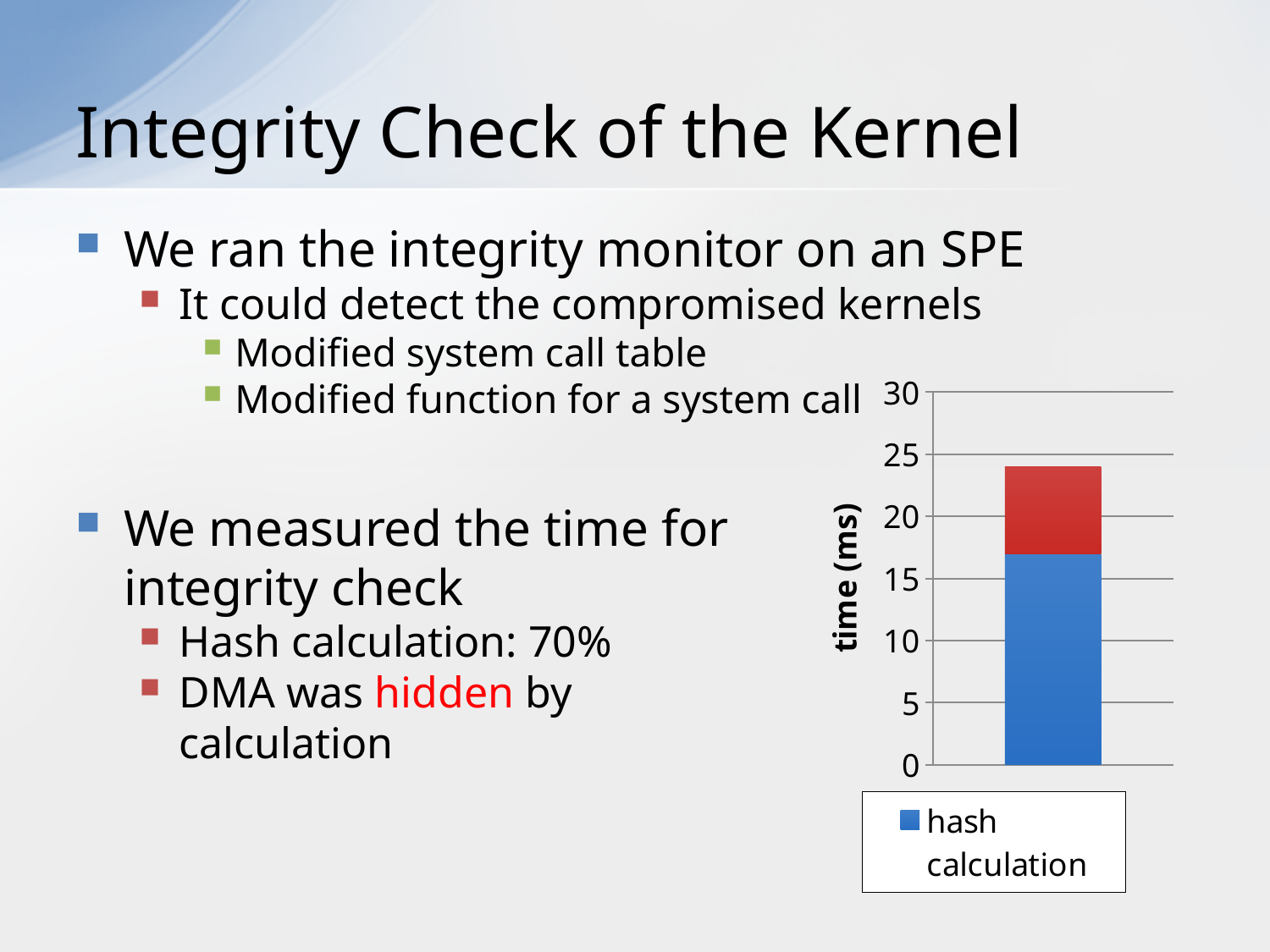
How many entries does the chart's legend list? 1 How many bars are plotted in the chart? 1 Which segment of the stacked bar is larger, the blue hash calculation segment or the red segment? blue hash calculation segment What is the label of the vertical axis of the chart? time (ms) Is the total height of the stacked bar greater or less than 25? less What is the highest tick value shown on the vertical axis of the chart? 30 Is the red segment of the stacked bar greater or less than 10? less Which series is listed in the chart's legend? hash calculation Is the total height of the stacked bar greater or less than 20? greater What kind of chart is shown on the slide? stacked bar chart